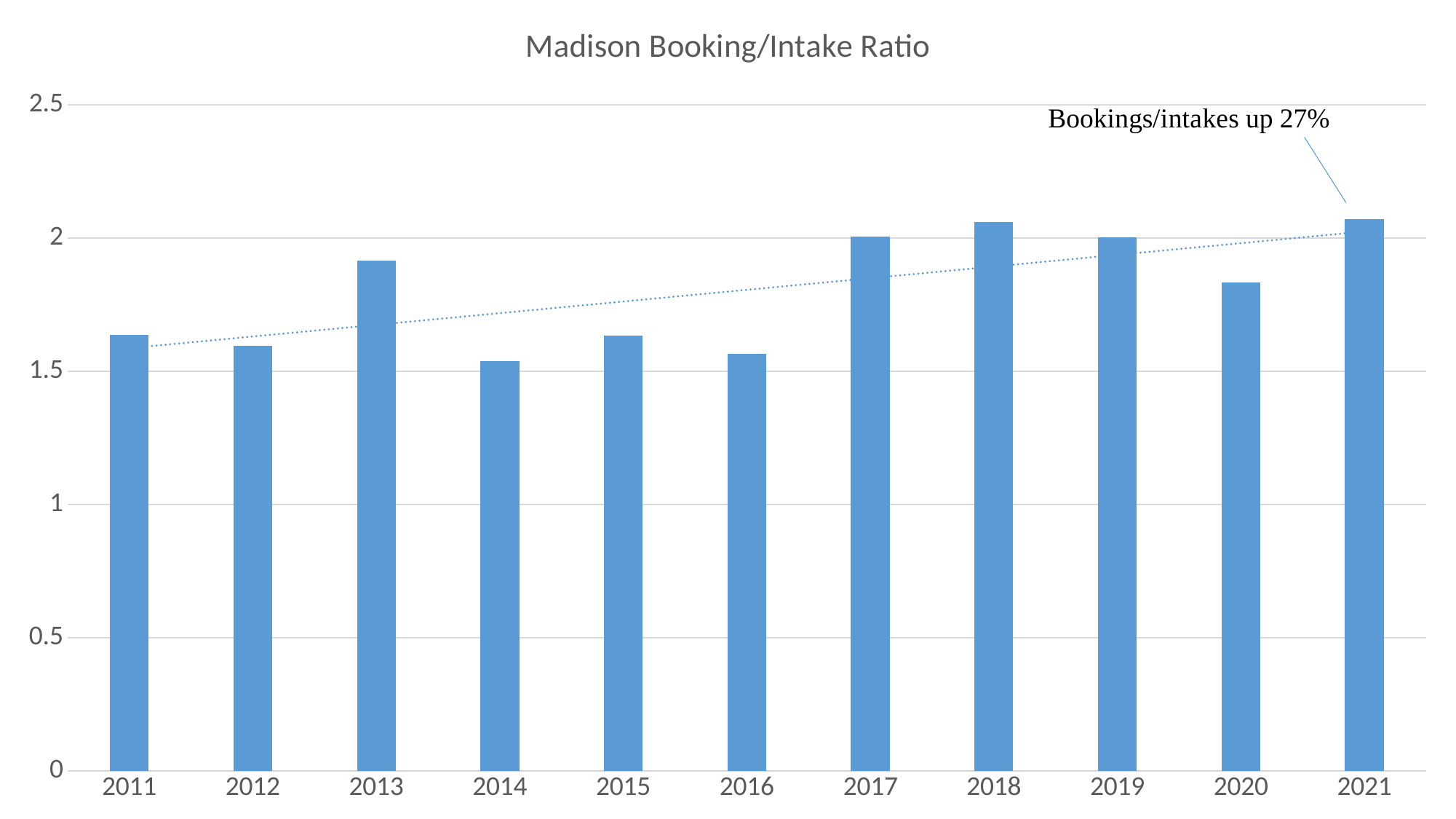
What is the title of the chart? Madison Booking/Intake Ratio Which year has the larger value, 2013 or 2014? 2013 Is the value for 2020 greater or less than 2? less What does the annotation pointing to the 2021 bar say? Bookings/intakes up 27% What kind of chart is shown on the slide? Bar chart Is the value for 2021 greater or less than 2? greater Which year has the larger value, 2018 or 2020? 2018 Is the value for 2018 greater or less than 2? greater Do the values generally rise or fall from 2011 to 2021 according to the dotted trend line? Rise How many years are plotted on the x axis of the chart? 11